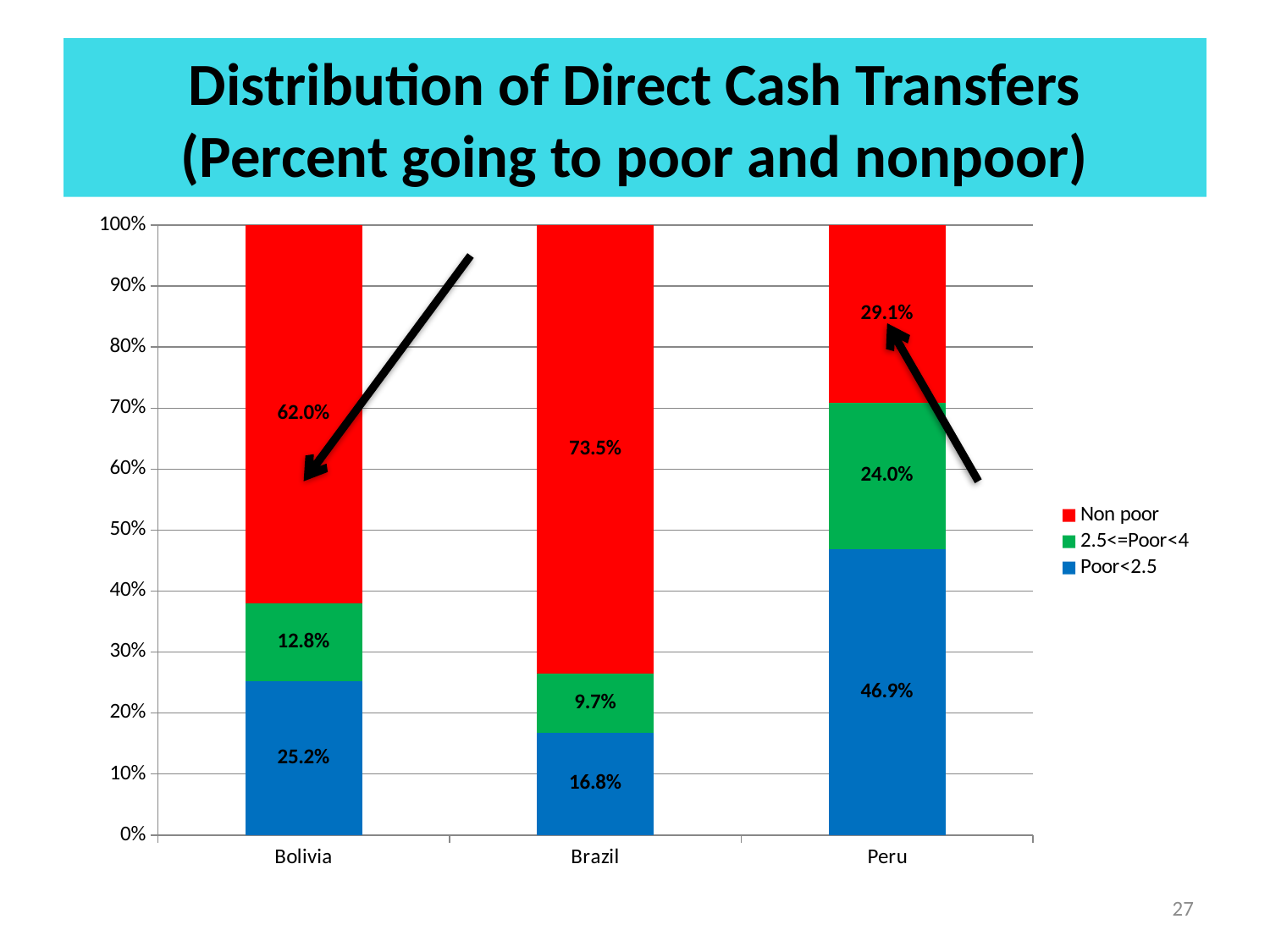
How many countries are shown on the x axis? 3 Which colour represents the Non poor series? Red What is the value for 2.5<=Poor<4 in Bolivia? 12.8% Which country has the lowest Poor<2.5 share? Brazil Which country has the highest Non poor share? Brazil How many series does the legend list? 3 What is the difference between the Non poor shares of Brazil and Bolivia? 11.5% Which is larger: the Poor<2.5 share in Peru or in Bolivia? Peru What is the value for Poor<2.5 in Peru? 46.9% What kind of chart is shown on the slide? Stacked bar chart What percentage of direct cash transfers in Brazil goes to the Non poor? 73.5% What is the Non poor share for Peru? 29.1%